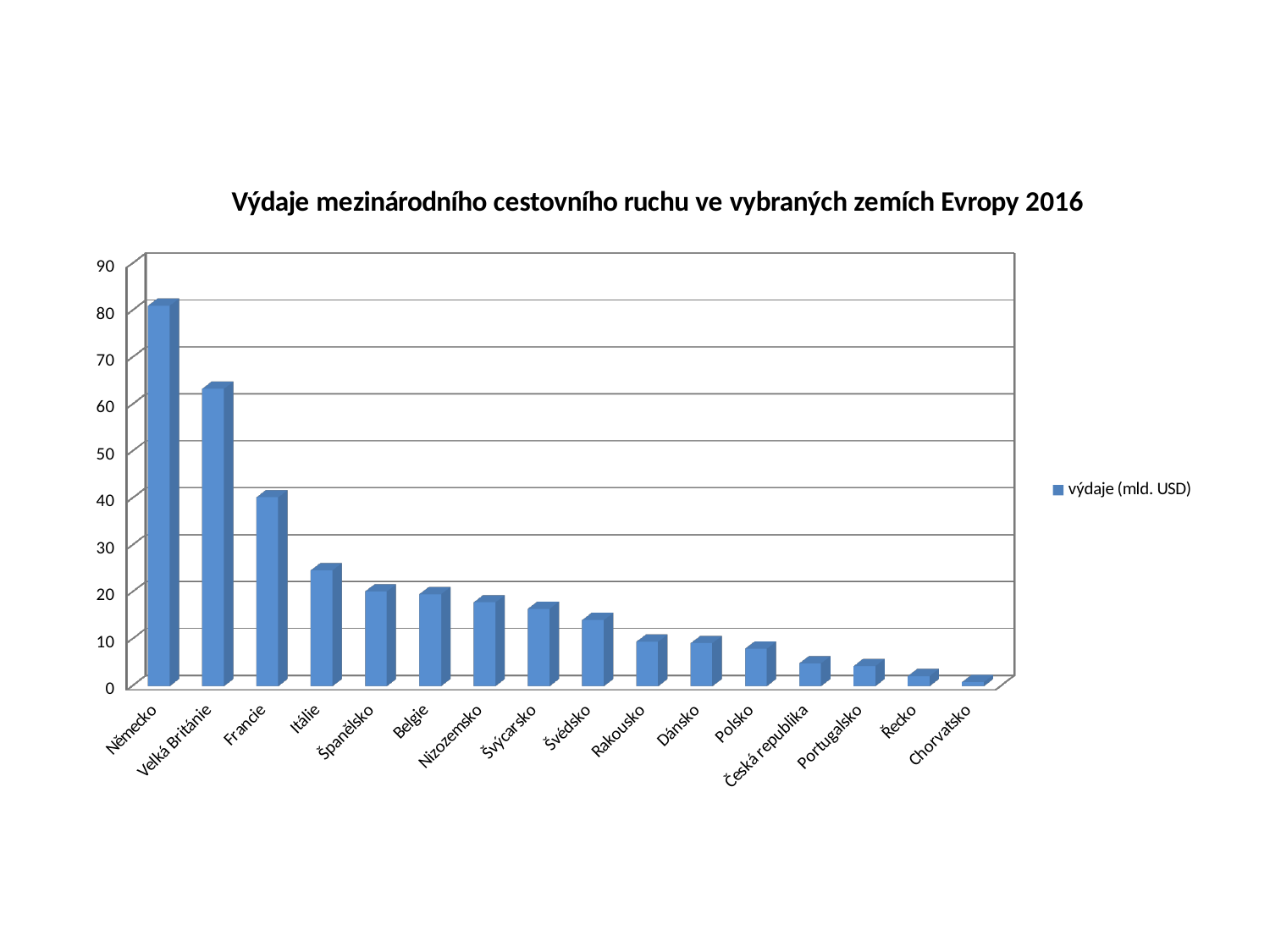
Is the value for Itálie greater or less than 30? less Which country has the highest value in the chart? Německo Is the value for Velká Británie greater or less than 50? greater Which country has the lowest value in the chart? Chorvatsko Is the value for Polsko greater or less than 10? less Do the values rise or fall moving from left to right along the x axis? fall How many countries are shown on the x axis of the chart? 16 How many series does the legend list? 1 Which is larger, the value for Francie or the value for Španělsko? Francie What kind of chart is shown on the slide? bar chart